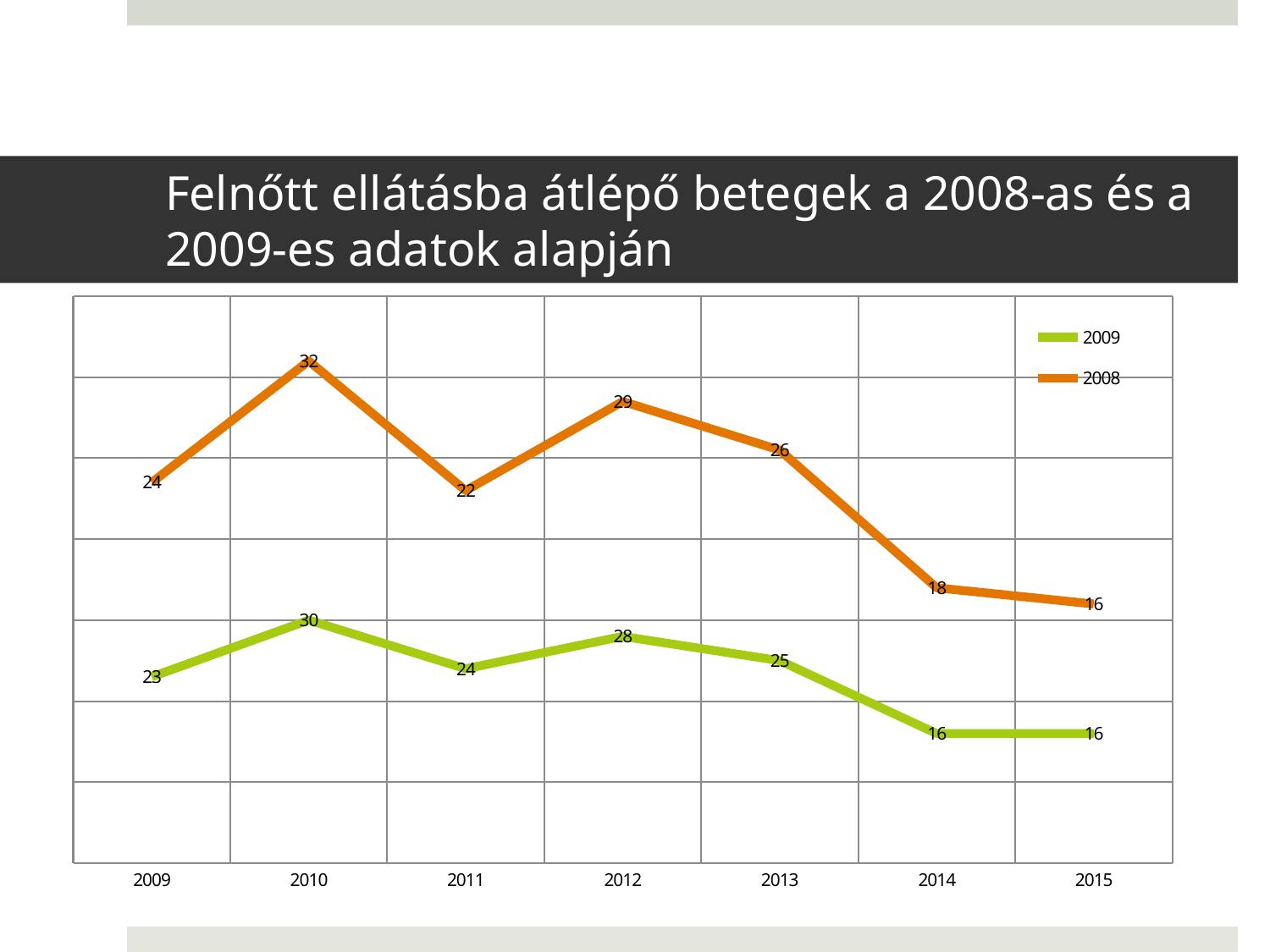
Which series has the larger value at 2013, 2008 or 2009? 2008 How many series does the legend list? 2 What is the value of the 2009 series at 2012? 28 What type of chart is shown on the slide? line chart What is the difference between the 2008 and 2009 series values at 2011? 2 In which year does the 2009 series reach its lowest value? 2014 and 2015 What colour is the line for the 2009 series? green In which year does the 2008 series reach its highest value? 2010 How many years are shown on the x axis? 7 What is the value of the 2008 series at 2010? 32 Does the 2008 series rise or fall from 2012 to 2015? fall What is the value of the 2008 series at 2014? 18